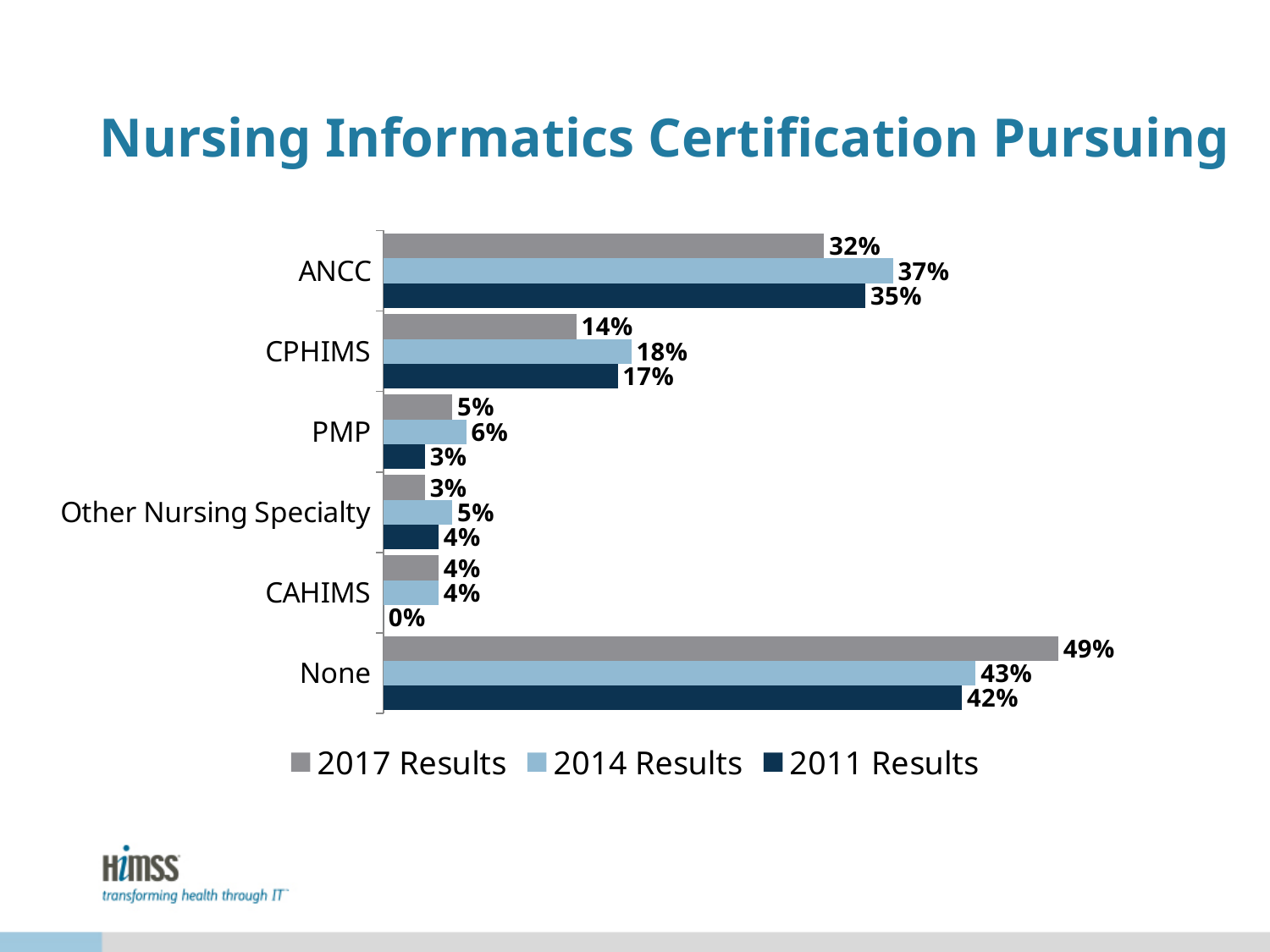
What is the 2011 Results value for CAHIMS? 0% Which is larger for ANCC: the 2014 Results value or the 2017 Results value? 2014 Results Which category has the highest 2017 Results value? None What is the 2014 Results value for CPHIMS? 18% What kind of chart is shown on the slide? Bar chart What is the difference between the 2017 Results and 2011 Results values for None? 7% What is the title of the chart? Nursing Informatics Certification Pursuing What is the 2017 Results value for ANCC? 32% How many categories are shown on the chart? 6 What is the 2011 Results value for None? 42% Which category has the lowest 2011 Results value? CAHIMS How many series does the legend list? 3